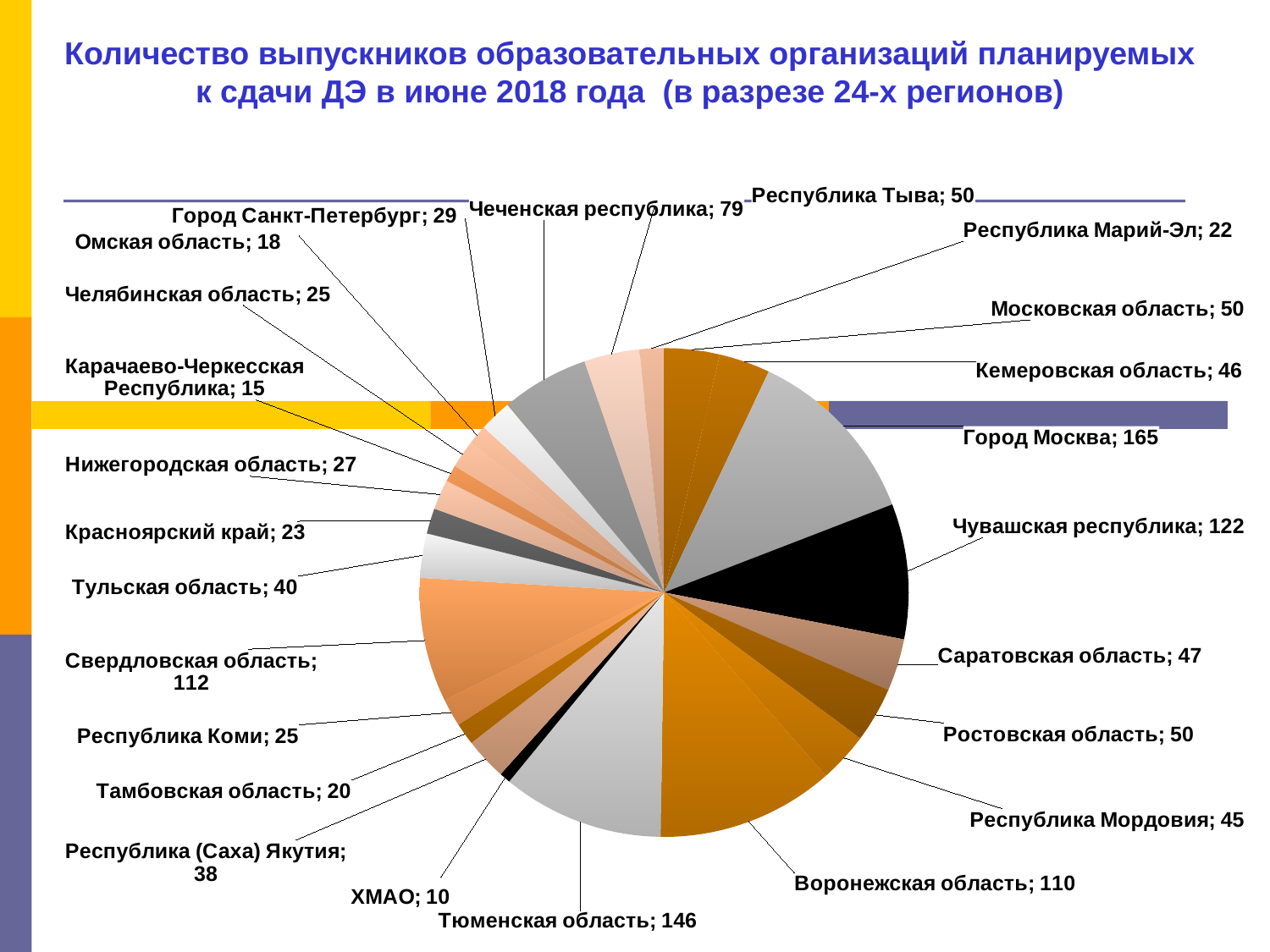
What is the difference between the values for Город Москва and Чувашская республика? 43 What is the value for Карачаево-Черкесская Республика? 15 Which region has the lowest value in the pie chart? ХМАО What is the value for Город Москва? 165 How many regions (slices) are shown in the pie chart? 24 Which region has the highest value in the pie chart? Город Москва Which is larger, the value for Чувашская республика or the value for Свердловская область? Чувашская республика What is the title of the chart on the slide? Количество выпускников образовательных организаций планируемых к сдачи ДЭ в июне 2018 года (в разрезе 24-х регионов) What is the value for Чеченская республика? 79 What is the difference between the values for Тюменская область and Воронежская область? 36 What is the value for Тюменская область? 146 What type of chart is shown on the slide? Pie chart